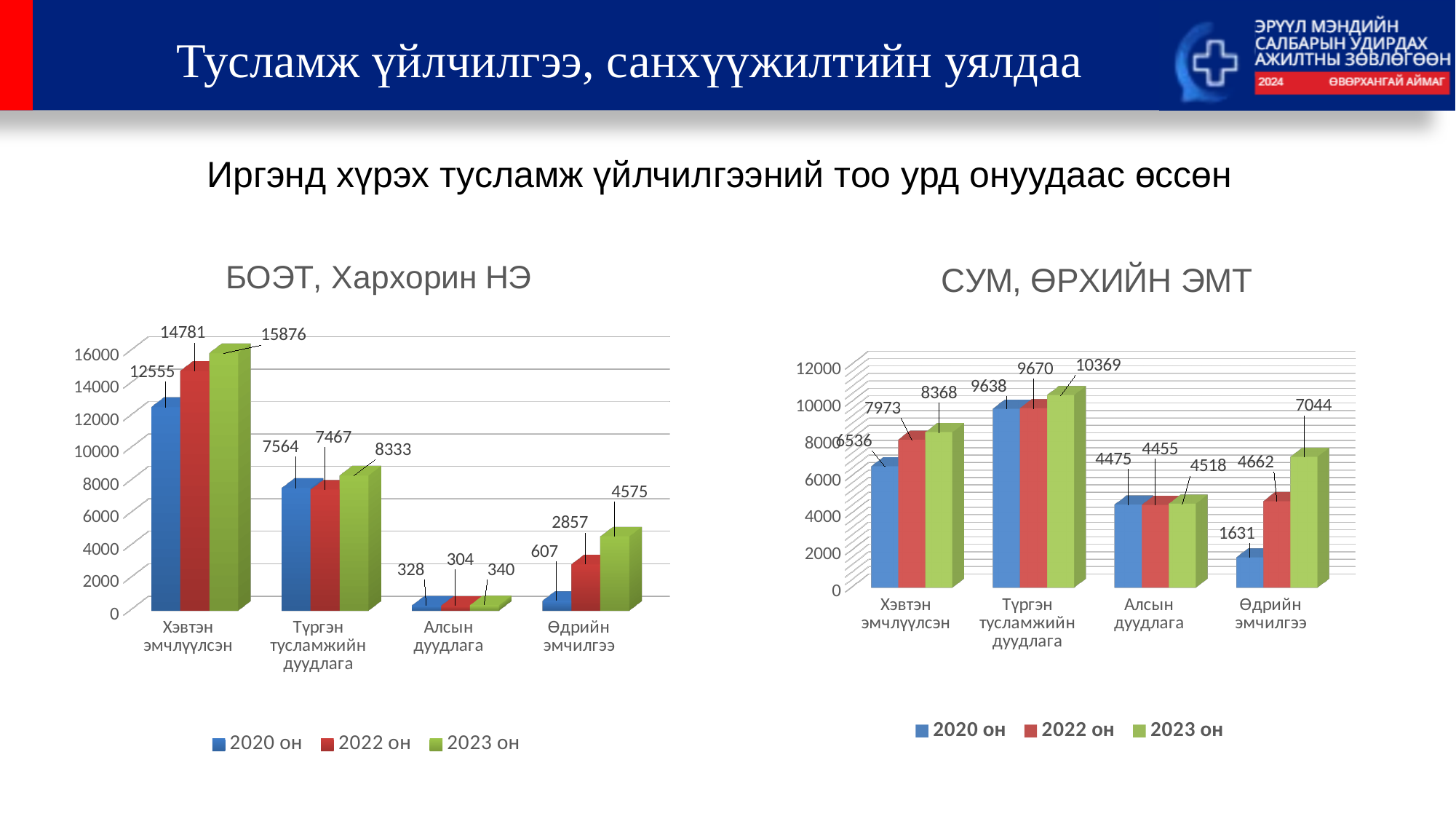
In the chart titled 'БОЭТ, Хархорин НЭ', what is the value for Өдрийн эмчилгээ in 2020 он? 607 In the chart titled 'БОЭТ, Хархорин НЭ', which category has the lowest value for 2022 он? Алсын дуудлага In the chart titled 'БОЭТ, Хархорин НЭ', what is the difference between the 2023 он and 2020 он values for Өдрийн эмчилгээ? 3968 In the chart titled 'СУМ, ӨРХИЙН ЭМТ', what is the value for Өдрийн эмчилгээ in 2022 он? 4662 In the chart titled 'СУМ, ӨРХИЙН ЭМТ', what is the value for Түргэн тусламжийн дуудлага in 2023 он? 10369 In the chart titled 'СУМ, ӨРХИЙН ЭМТ', which category has the highest value for 2020 он? Түргэн тусламжийн дуудлага How many series does the legend of the chart titled 'СУМ, ӨРХИЙН ЭМТ' list? 3 What kind of chart is the chart titled 'СУМ, ӨРХИЙН ЭМТ'? Bar chart In the chart titled 'БОЭТ, Хархорин НЭ', what is the value for Хэвтэн эмчлүүлсэн in 2023 он? 15876 In the chart titled 'БОЭТ, Хархорин НЭ', which is larger for Түргэн тусламжийн дуудлага: the 2020 он value or the 2023 он value? 2023 он In the chart titled 'СУМ, ӨРХИЙН ЭМТ', what is the difference between the 2023 он and 2020 он values for Хэвтэн эмчлүүлсэн? 1832 How many categories are shown on the x axis of the chart titled 'БОЭТ, Хархорин НЭ'? 4